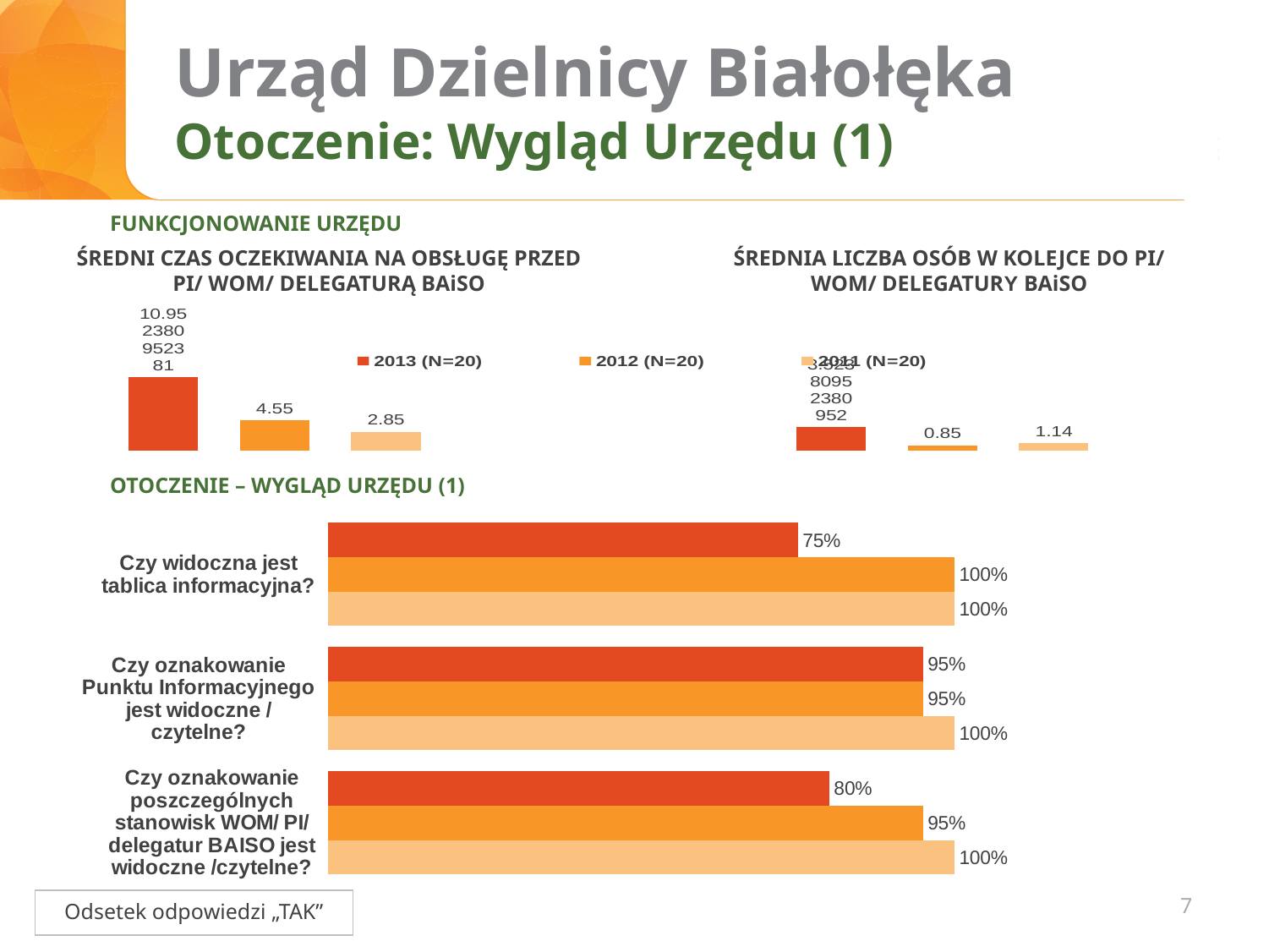
In the bottom chart 'OTOCZENIE – WYGLĄD URZĘDU (1)', what is the value of the red (2013) bar for 'Czy oznakowanie poszczególnych stanowisk WOM/ PI/ delegatur BAISO jest widoczne /czytelne?'? 80% What type of chart is the bottom chart 'OTOCZENIE – WYGLĄD URZĘDU (1)'? Bar chart In the chart 'ŚREDNIA LICZBA OSÓB W KOLEJCE DO PI/ WOM/ DELEGATURY BAiSO', which is larger, the value for 2012 or for 2011? 2011 In the bottom chart 'OTOCZENIE – WYGLĄD URZĘDU (1)', what is the difference between the light orange (2011) bar and the red (2013) bar for 'Czy widoczna jest tablica informacyjna?'? 25% In the chart 'ŚREDNIA LICZBA OSÓB W KOLEJCE DO PI/ WOM/ DELEGATURY BAiSO', what is the value for 2011 (N=20)? 1.14 In the chart 'ŚREDNIA LICZBA OSÓB W KOLEJCE DO PI/ WOM/ DELEGATURY BAiSO', what is the value for 2012 (N=20)? 0.85 How many series does the legend above the top charts list? 3 In the chart 'ŚREDNI CZAS OCZEKIWANIA NA OBSŁUGĘ PRZED PI/ WOM/ DELEGATURĄ BAiSO', which year has the highest value? 2013 (N=20) In the chart 'ŚREDNI CZAS OCZEKIWANIA NA OBSŁUGĘ PRZED PI/ WOM/ DELEGATURĄ BAiSO', what is the value for 2011 (N=20)? 2.85 How many question categories are shown in the bottom chart 'OTOCZENIE – WYGLĄD URZĘDU (1)'? 3 In the chart 'ŚREDNI CZAS OCZEKIWANIA NA OBSŁUGĘ PRZED PI/ WOM/ DELEGATURĄ BAiSO', what is the value for 2012 (N=20)? 4.55 In the bottom chart 'OTOCZENIE – WYGLĄD URZĘDU (1)', what is the value of the red (2013) bar for 'Czy widoczna jest tablica informacyjna?'? 75%